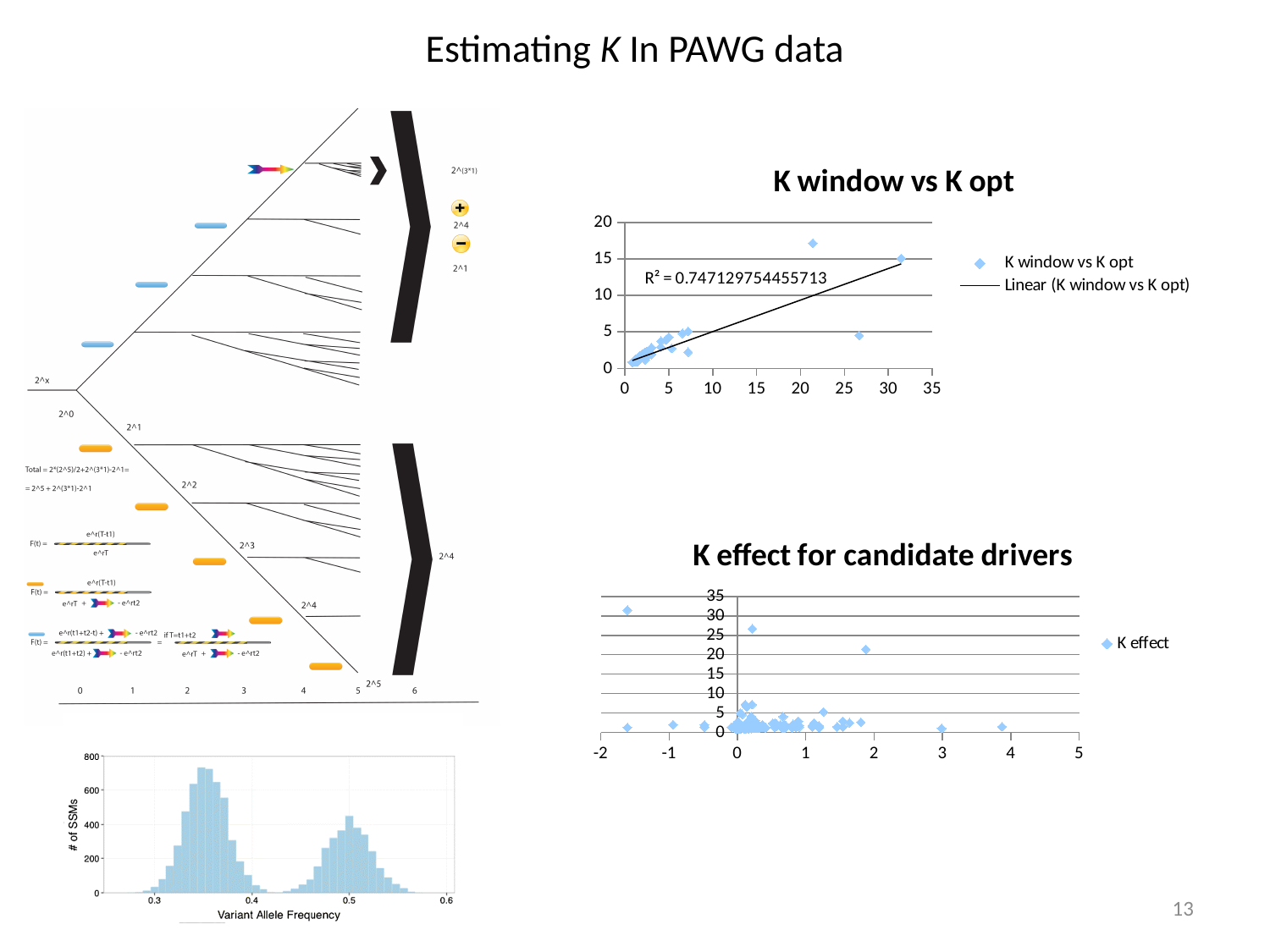
What kind of chart is "K window vs K opt"? scatter chart In the "K window vs K opt" chart, is the highest plotted point greater or less than 15 on the y axis? greater What is the maximum value shown on the y axis of the "K window vs K opt" chart? 20 In the histogram at the bottom left of the slide, which peak is taller: the one near a Variant Allele Frequency of 0.35 or the one near 0.5? the one near 0.35 What is the title of the lower-right chart on the slide? K effect for candidate drivers In the "K effect for candidate drivers" chart, is the highest plotted point greater or less than 30 on the y axis? greater In the "K effect for candidate drivers" chart, is the point plotted near x = 2 greater or less than 15 on the y axis? greater What kind of chart is "K effect for candidate drivers"? scatter chart What is the R² value shown on the "K window vs K opt" chart? 0.747129754455713 How many entries does the legend of the "K window vs K opt" chart list? 2 How many series does the legend of the "K effect for candidate drivers" chart list? 1